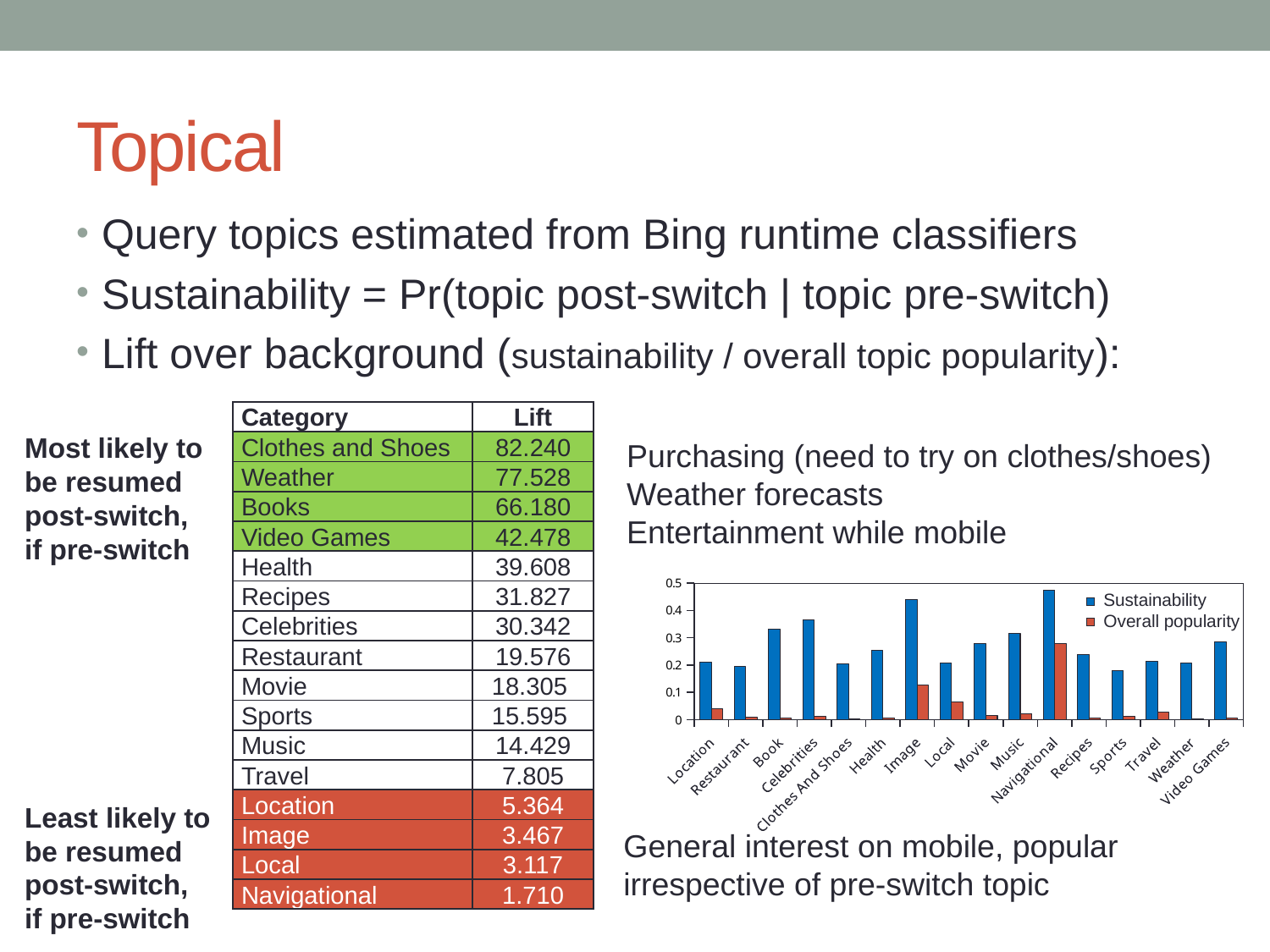
Is the Sustainability value for Celebrities greater or less than 0.3? greater How many series does the chart's legend list? 2 What kind of chart is shown on the slide? bar chart Is the Sustainability value for Image greater or less than 0.4? greater Which has the larger Overall popularity value, Navigational or Image? Navigational Which has the larger Sustainability value, Video Games or Weather? Video Games Is the Overall popularity value for Navigational greater or less than 0.2? greater Which has the larger Sustainability value, Book or Location? Book Which category has the highest Overall popularity value in the chart? Navigational How many categories are shown along the x axis of the chart? 16 Which colour represents the Sustainability series in the chart? blue